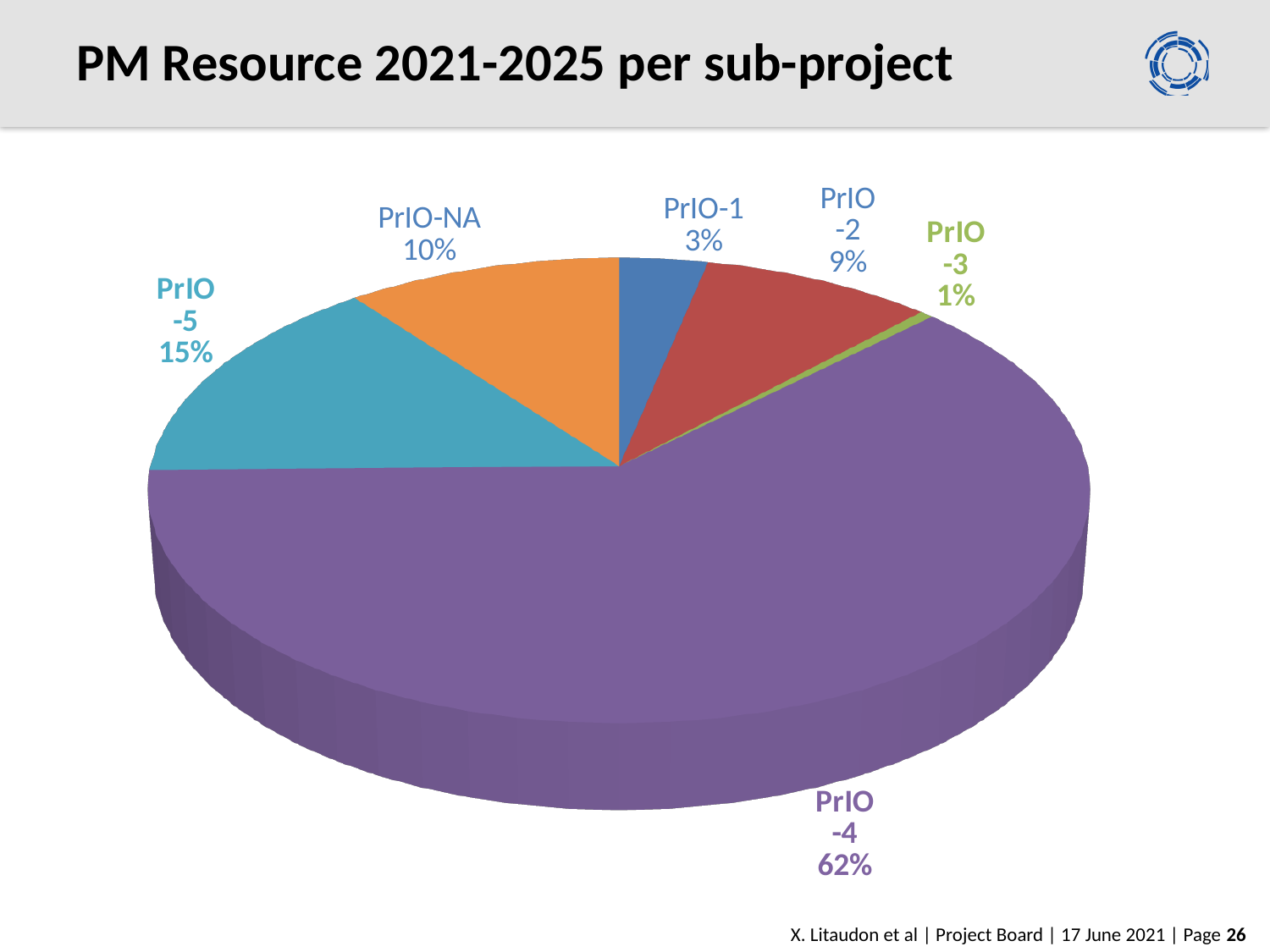
What share of the pie does PrIO-1 have? 3% Which sub-project has the largest share of the pie? PrIO-4 Which has the larger share, PrIO-2 or PrIO-1? PrIO-2 What share of the pie does PrIO-5 have? 15% What is the difference in percentage points between the shares of PrIO-5 and PrIO-NA? 5 What share of the pie does PrIO-NA have? 10% How many slices does the pie chart have? 6 What kind of chart is shown on the slide? pie chart Which sub-project has the smallest share of the pie? PrIO-3